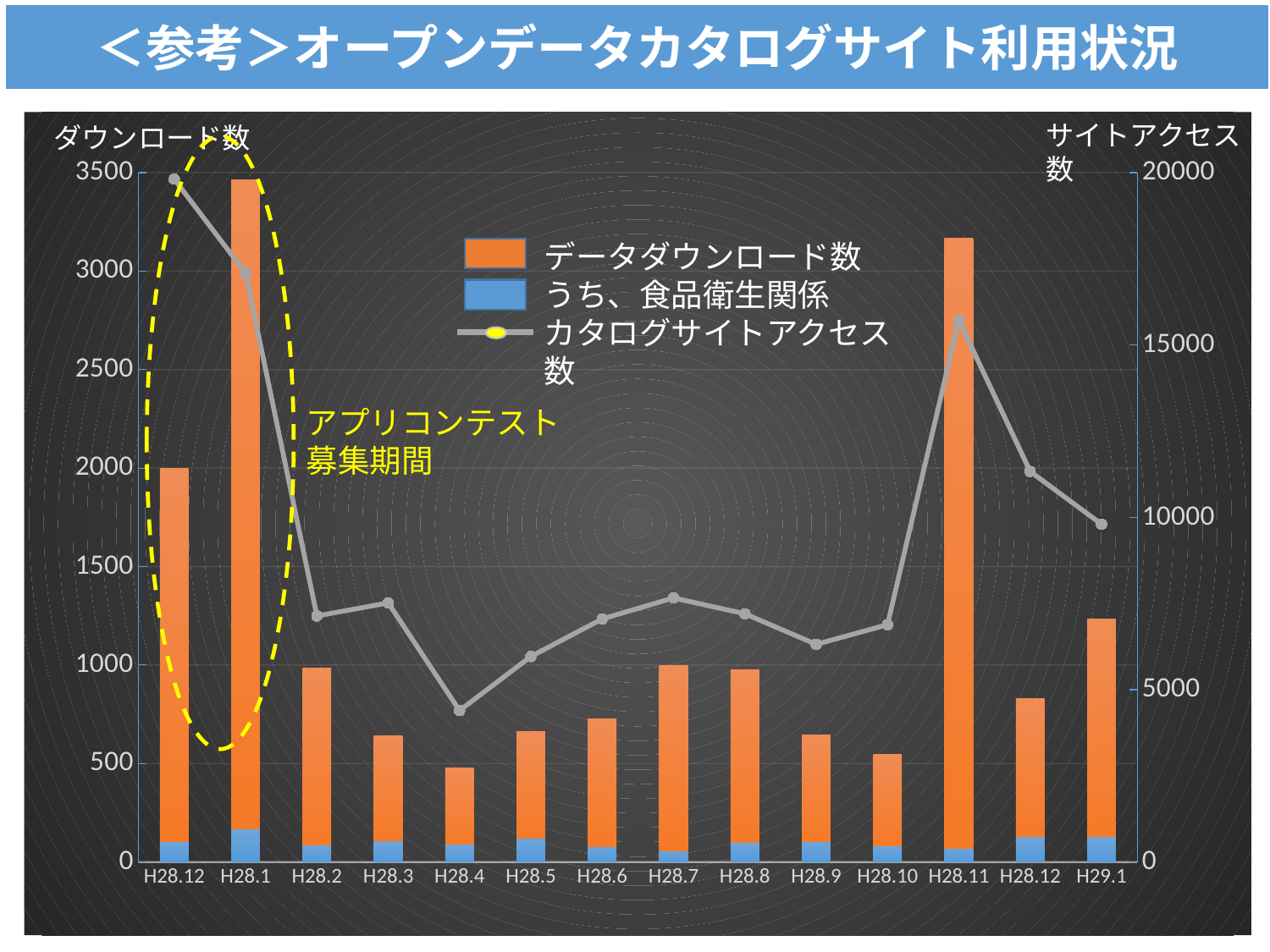
How many categories (months) are shown on the x axis? 14 Is the カタログサイトアクセス数 value for the leftmost H28.12 greater or less than 15000? greater At which month does the カタログサイトアクセス数 line reach its lowest point? H28.4 Which month has the lowest データダウンロード数 bar? H28.4 At which month does the カタログサイトアクセス数 line reach its highest point? H28.12 (the leftmost month) How many series does the legend list? 3 Is the データダウンロード数 bar for H28.11 greater or less than 3000? greater What is the title of the left vertical axis? ダウンロード数 What kind of chart is shown on the slide? A combination of a stacked bar chart and a line chart Is the データダウンロード数 bar for H28.10 greater or less than 1000? less Which month has the highest データダウンロード数 bar? H28.1 Which has the larger データダウンロード数 bar, H28.1 or H28.11? H28.1